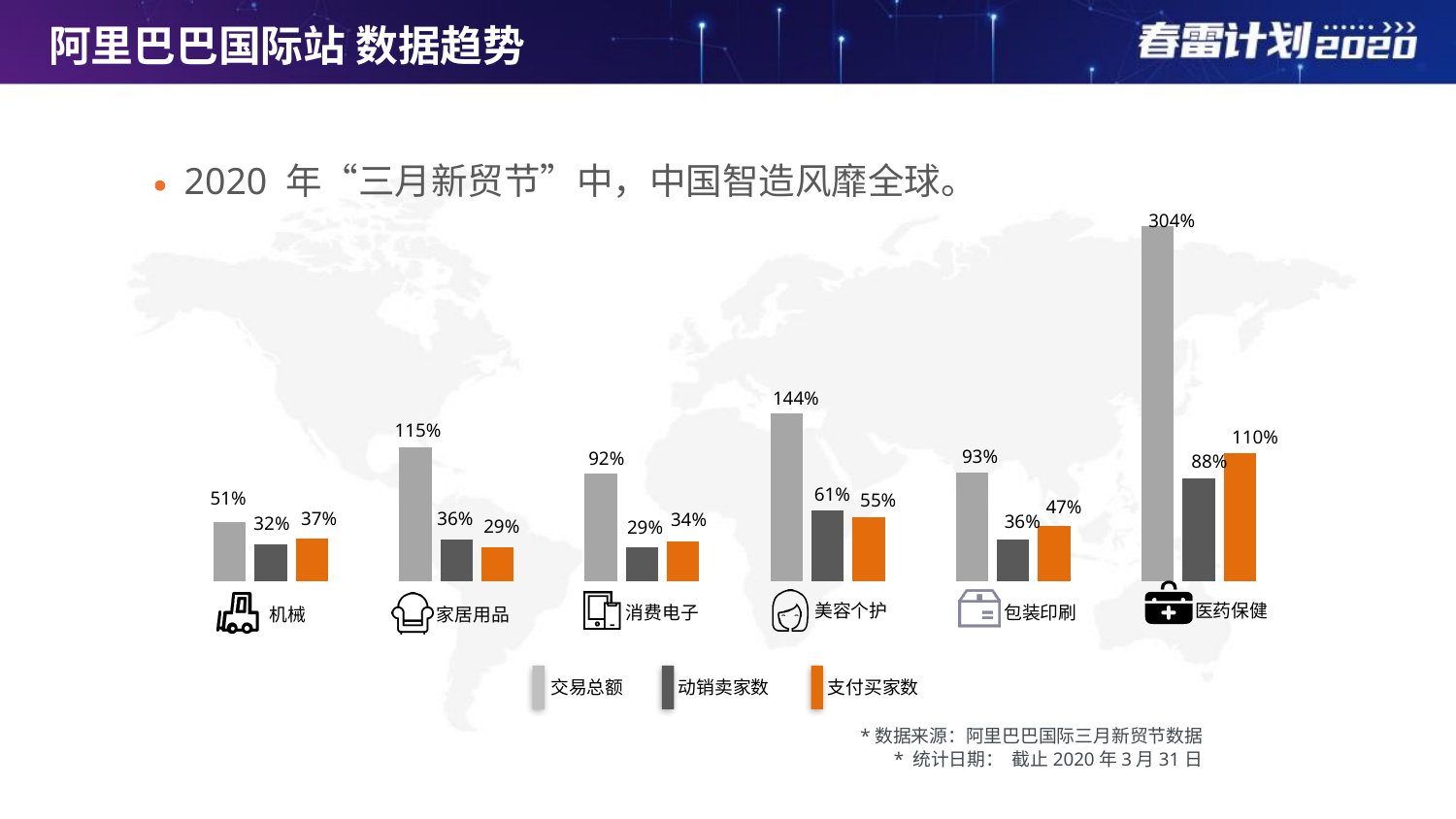
Which category has the lowest 交易总额 value? 机械 What is the 交易总额 value for 医药保健? 304% What is the difference between the 交易总额 values for 美容个护 and 消费电子? 52% What is the 支付买家数 value for 包装印刷? 47% Which category has the highest 交易总额 value? 医药保健 Which is larger for 机械: 动销卖家数 or 支付买家数? 支付买家数 What is the 动销卖家数 value for 美容个护? 61% How many categories are shown on the chart? 6 What kind of chart is shown on the slide? bar chart Which category has the lowest 支付买家数 value? 家居用品 How many series does the legend list? 3 What is the 交易总额 value for 家居用品? 115%